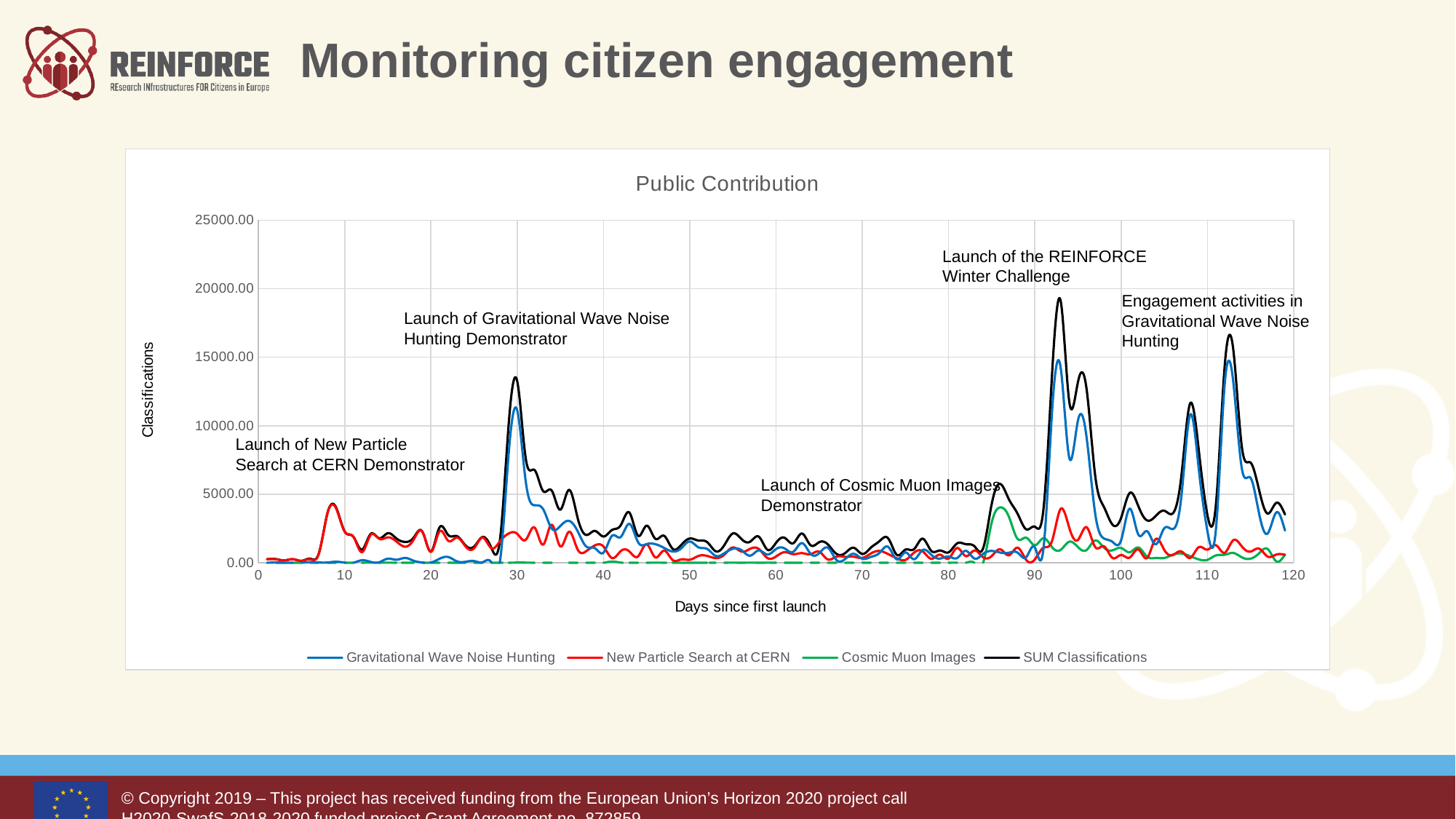
What is the title of the chart? Public Contribution Is the peak value of Cosmic Muon Images around day 86 greater or less than 5000.00? less Is the value of SUM Classifications at day 60 greater or less than 5000.00? less Around day 93, which series is higher: Gravitational Wave Noise Hunting or New Particle Search at CERN? Gravitational Wave Noise Hunting What kind of chart is shown on the slide? line chart What is the label of the x axis of the chart? Days since first launch Is the peak value of Gravitational Wave Noise Hunting around day 30 greater or less than 10000.00? greater Which series reaches the highest value anywhere on the chart? SUM Classifications How many series does the legend of the Public Contribution chart list? 4 Around day 9, which series is higher: New Particle Search at CERN or Gravitational Wave Noise Hunting? New Particle Search at CERN